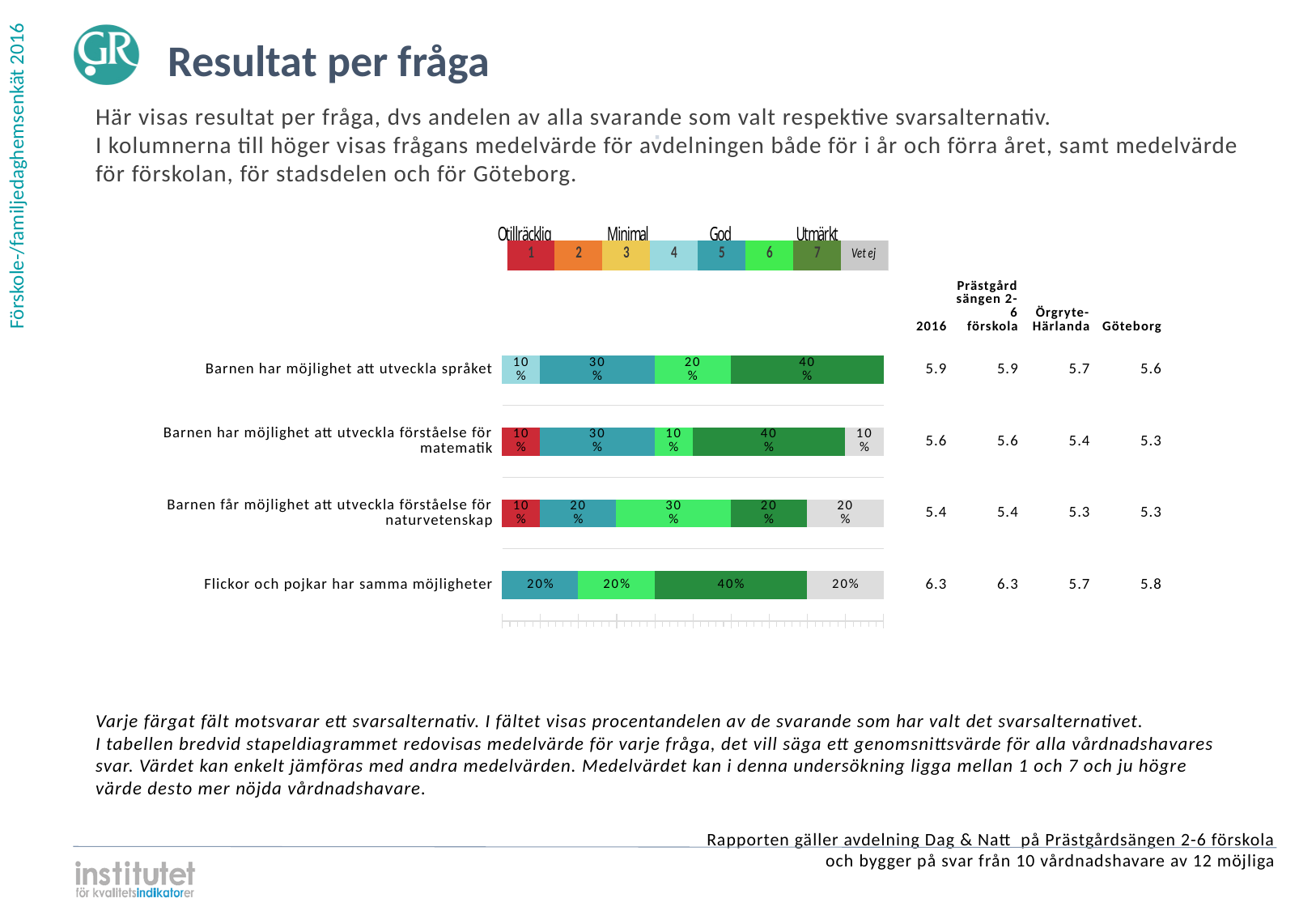
What kind of chart is shown on the slide? Stacked bar chart How many questions (categories) are plotted in the bar chart? 4 What percentage of respondents chose answer 7 (dark green) for 'Barnen har möjlighet att utveckla språket'? 40% What percentage of respondents chose answer 6 (light green) for 'Flickor och pojkar har samma möjligheter'? 20% What is the 2016 mean value shown for 'Flickor och pojkar har samma möjligheter'? 6.3 What percentage of respondents chose 'Vet ej' for 'Barnen får möjlighet att utveckla förståelse för naturvetenskap'? 20% Which question has the largest share of answer 6 (light green)? Barnen får möjlighet att utveckla förståelse för naturvetenskap What is the Göteborg mean value shown for 'Barnen har möjlighet att utveckla förståelse för matematik'? 5.3 How many answer options does the legend above the chart list, including 'Vet ej'? 8 What is the difference between the answer 7 share and the answer 6 share for 'Barnen har möjlighet att utveckla förståelse för matematik'? 30% What percentage of respondents chose answer 1 (red) for 'Barnen har möjlighet att utveckla förståelse för matematik'? 10% Is the answer 7 share larger for 'Barnen har möjlighet att utveckla språket' or for 'Barnen får möjlighet att utveckla förståelse för naturvetenskap'? Barnen har möjlighet att utveckla språket